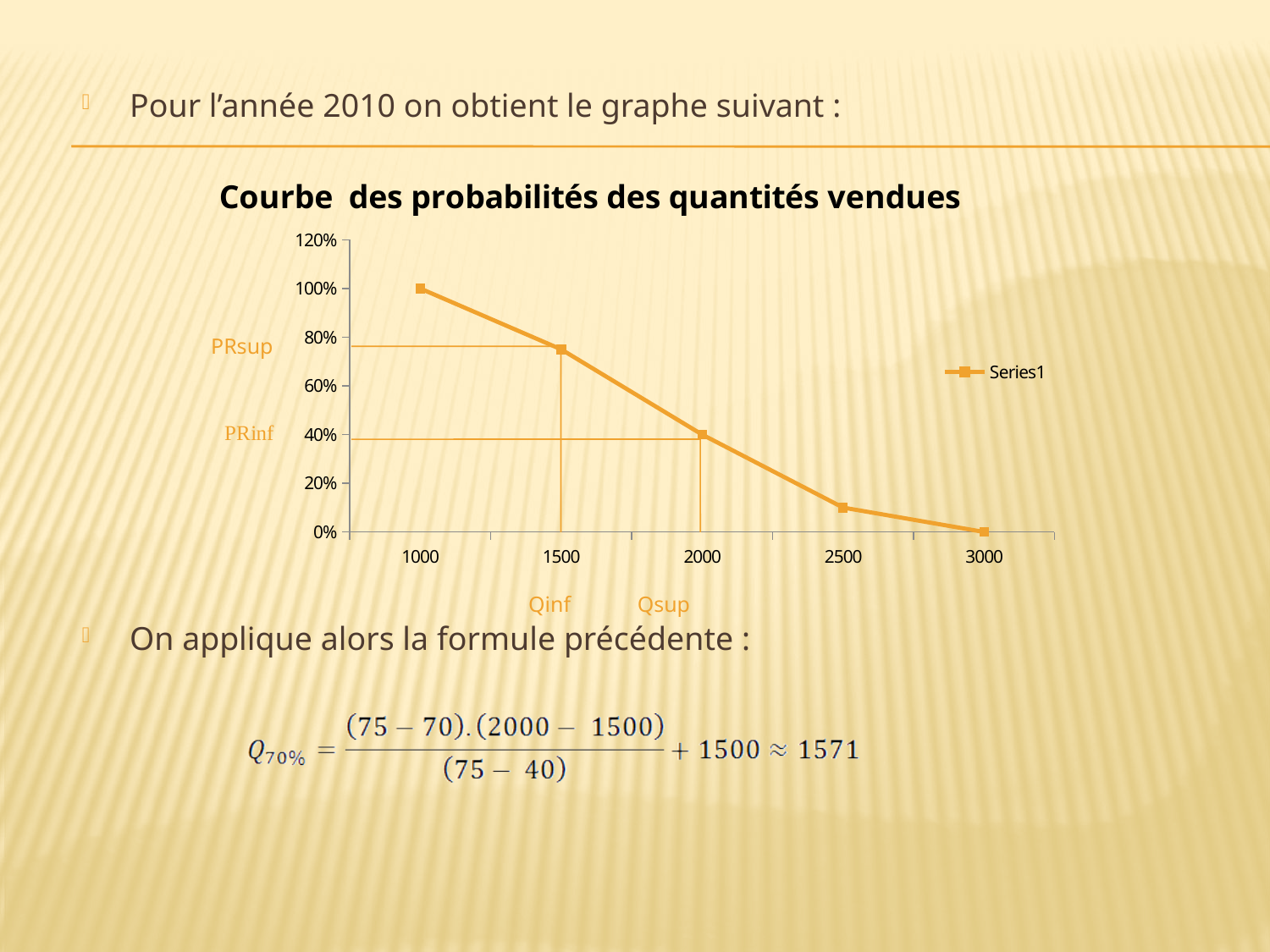
At which quantity is the probability lowest? 3000 How many series does the legend list? 1 Do the values rise or fall as the quantity increases along the x axis? fall Is the value at quantity 1500 greater or less than 60%? greater What is the probability value at quantity 2000? 40% At which quantity is the probability highest? 1000 Is the value at quantity 2500 greater or less than 20%? less What is the probability value at quantity 1000? 100% What is the difference between the values at quantity 1000 and quantity 2000? 60% How many data points are plotted on the line? 5 What kind of chart is shown on the slide? line chart What is the probability value at quantity 3000? 0%